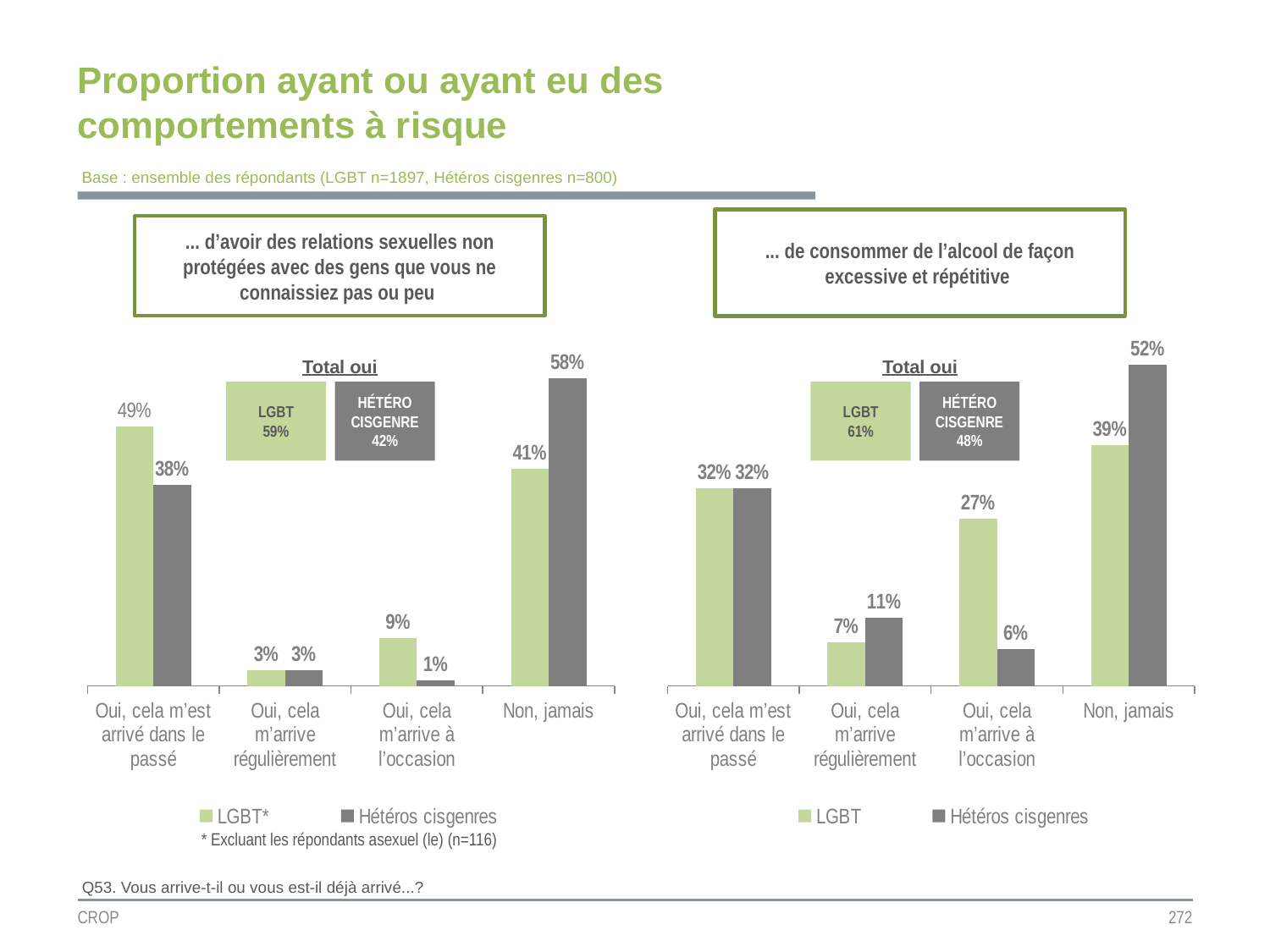
What kind of chart is the right chart (alcool de façon excessive et répétitive)? Bar chart In the left chart (relations sexuelles non protégées), what is the difference between the LGBT and Hétéros cisgenres values for "Oui, cela m'arrive à l'occasion"? 8% In the left chart (relations sexuelles non protégées), what is the "Total oui" value for LGBT? 59% How many categories are shown on the x axis of the left chart (relations sexuelles non protégées)? 4 In the right chart (alcool de façon excessive et répétitive), which category has the highest LGBT value? Non, jamais In the right chart (alcool de façon excessive et répétitive), which is larger for "Oui, cela m'arrive à l'occasion": the LGBT value or the Hétéros cisgenres value? LGBT In the left chart (relations sexuelles non protégées), which category has the lowest Hétéros cisgenres value? Oui, cela m'arrive à l'occasion In the right chart (alcool de façon excessive et répétitive), what is the difference between the Hétéros cisgenres and LGBT values for "Non, jamais"? 13% In the right chart (alcool de façon excessive et répétitive), what is the "Total oui" value for Hétéro cisgenre? 48% In the left chart (relations sexuelles non protégées), what is the LGBT value for "Oui, cela m'est arrivé dans le passé"? 49% In the right chart (alcool de façon excessive et répétitive), what is the Hétéros cisgenres value for "Oui, cela m'arrive régulièrement"? 11% In the left chart (relations sexuelles non protégées), what is the Hétéros cisgenres value for "Non, jamais"? 58%